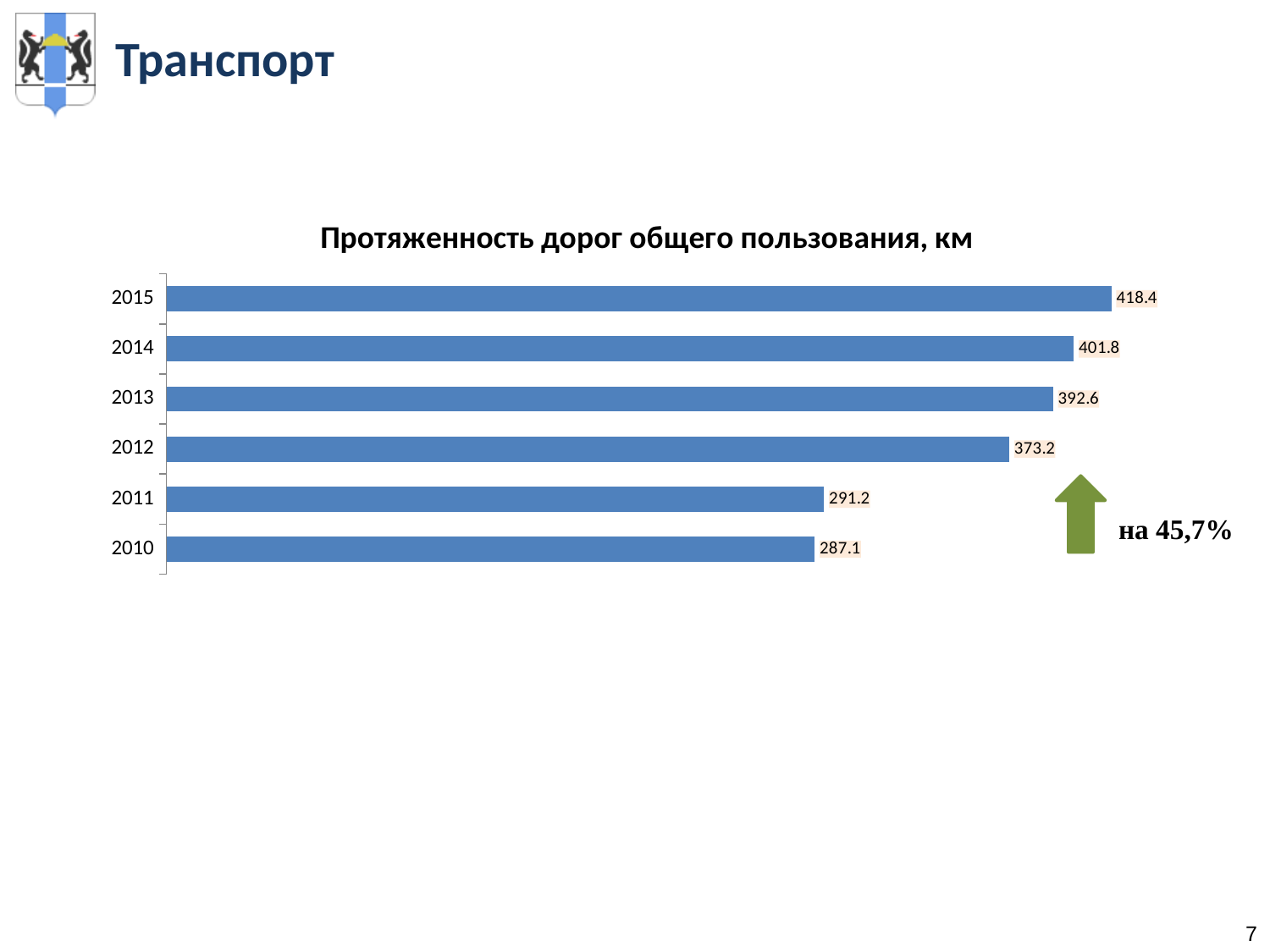
Which is larger, the value for 2013 or the value for 2014? 2014 What kind of chart is this? bar chart What is the value for 2010? 287.1 Which year has the lowest value? 2010 How many years are shown in the chart? 6 What is the difference between the values for 2012 and 2011? 82.0 What is the value for 2012? 373.2 What is the difference between the values for 2015 and 2010? 131.3 What is the title of the chart? Протяженность дорог общего пользования, км What is the value for 2015? 418.4 Which year has the highest value? 2015 Do the values rise or fall from 2010 to 2015? rise